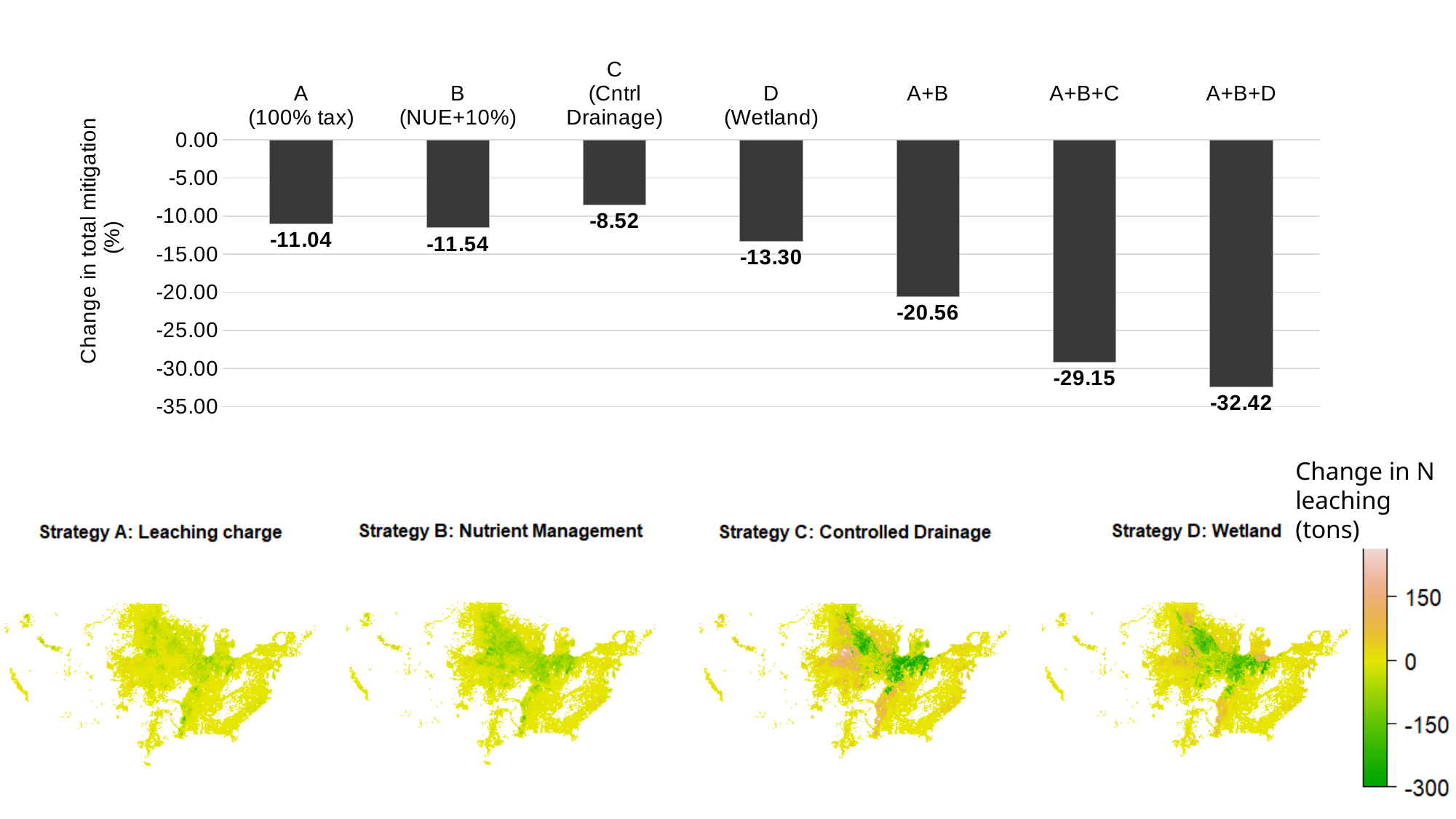
How many categories are shown in the bar chart? 7 What is the value for C (Cntrl Drainage) in the bar chart? -8.52 Which category in the bar chart has the value closest to zero (the smallest reduction)? C (Cntrl Drainage) What is the value for A+B+C in the bar chart? -29.15 In the bar chart, which shows a larger reduction: A+B or D (Wetland)? A+B What is the difference between the values for A+B+D and A+B+C in the bar chart? 3.27 What kind of chart is shown at the top of the slide? Bar chart What is the value for D (Wetland) in the bar chart? -13.30 How many strategy maps are shown below the bar chart? 4 Which category in the bar chart has the lowest (most negative) value? A+B+D What is the label of the vertical axis of the bar chart? Change in total mitigation (%) What is the difference between the values for A (100% tax) and B (NUE+10%) in the bar chart? 0.50